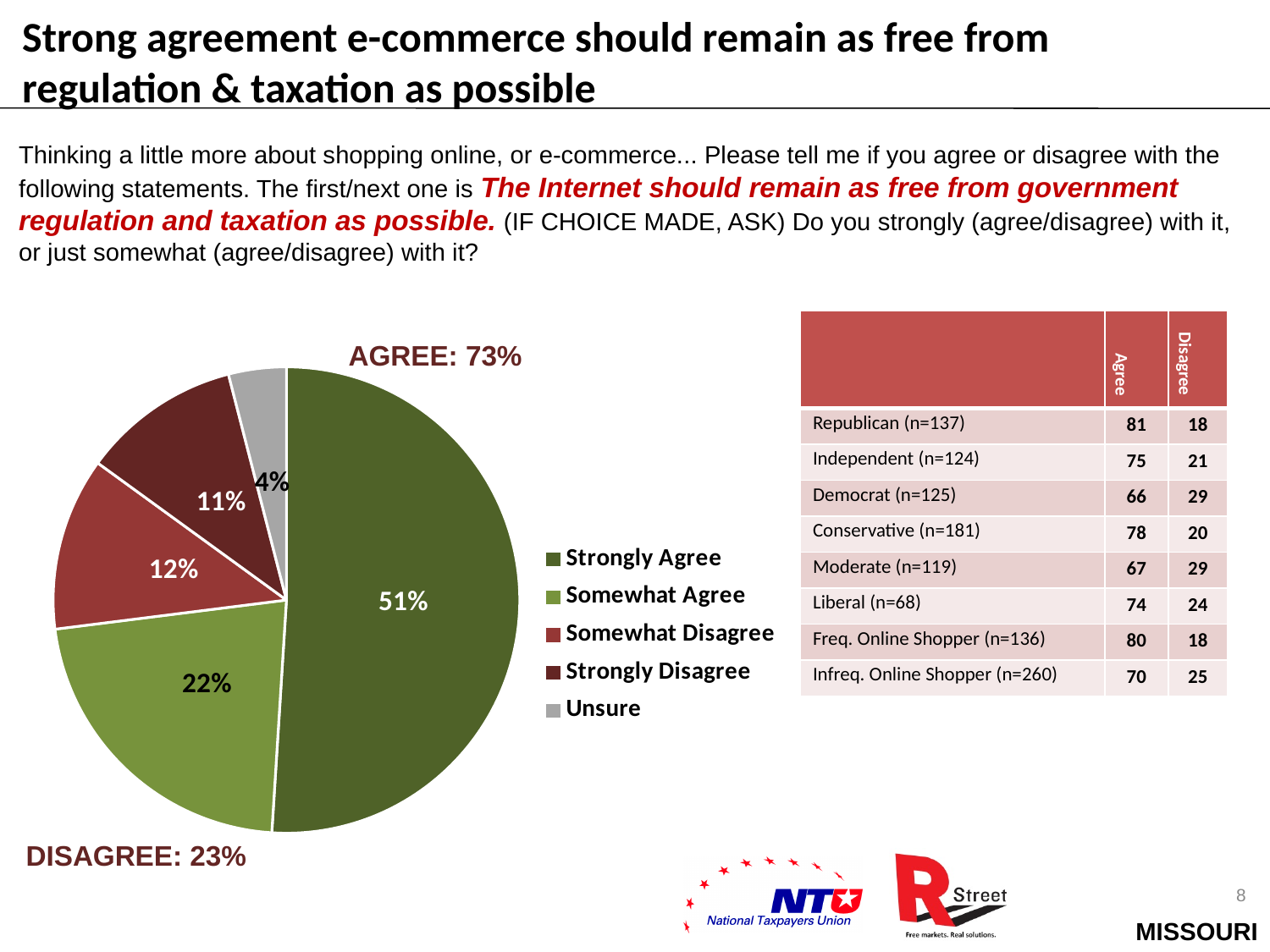
What share of the pie is Strongly Agree? 51% What is the value for Somewhat Disagree? 12% Which is larger, Somewhat Disagree or Strongly Disagree? Somewhat Disagree Which slice of the pie is the smallest? Unsure What is the value for Unsure? 4% What kind of chart is shown on the slide? pie chart What is the value for Strongly Disagree? 11% What is the difference between the Strongly Agree and Somewhat Agree slices? 29 percentage points Which slice of the pie is the largest? Strongly Agree What is the value for Somewhat Agree? 22% How many slices does the pie chart have? 5 How many entries does the legend list? 5